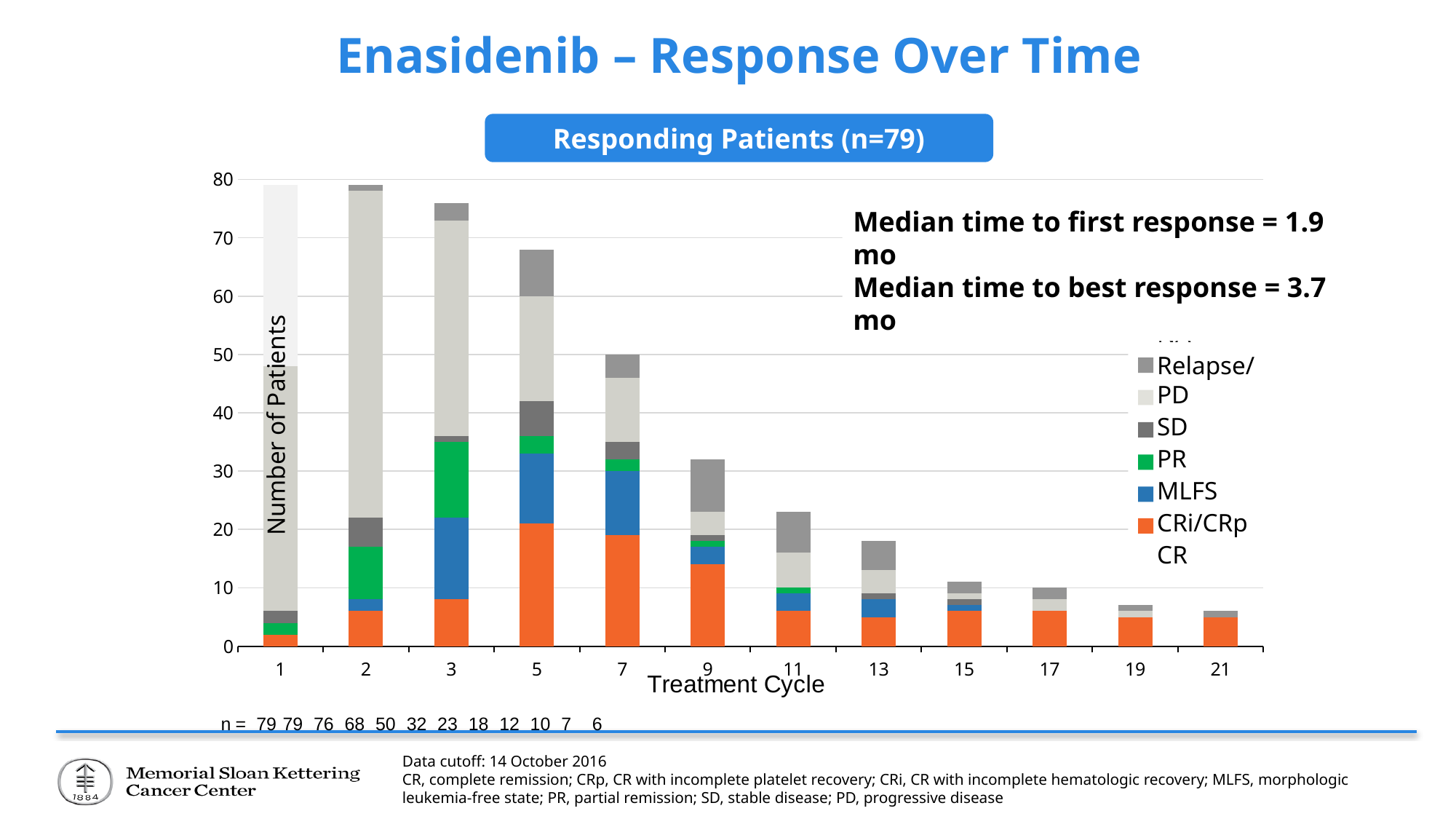
Which has a larger total number of patients, treatment cycle 7 or treatment cycle 11? Treatment cycle 7 What is the difference in total patients between treatment cycle 2 and treatment cycle 3? 3 What is the total number of patients (n) at treatment cycle 5? 68 What is the label of the x axis? Treatment Cycle Do the total bar heights rise or fall as the treatment cycle increases? Fall Is the CR value at treatment cycle 3 greater or less than 10? less Which treatment cycle has the lowest total number of patients? 21 What is the difference in total patients between treatment cycle 5 and treatment cycle 7? 18 What is the total number of patients (n) at treatment cycle 21? 6 What is the total number of patients (n) at treatment cycle 9? 32 What kind of chart is shown on the slide? Stacked bar chart How many treatment cycles (bars) are plotted on the x axis? 12